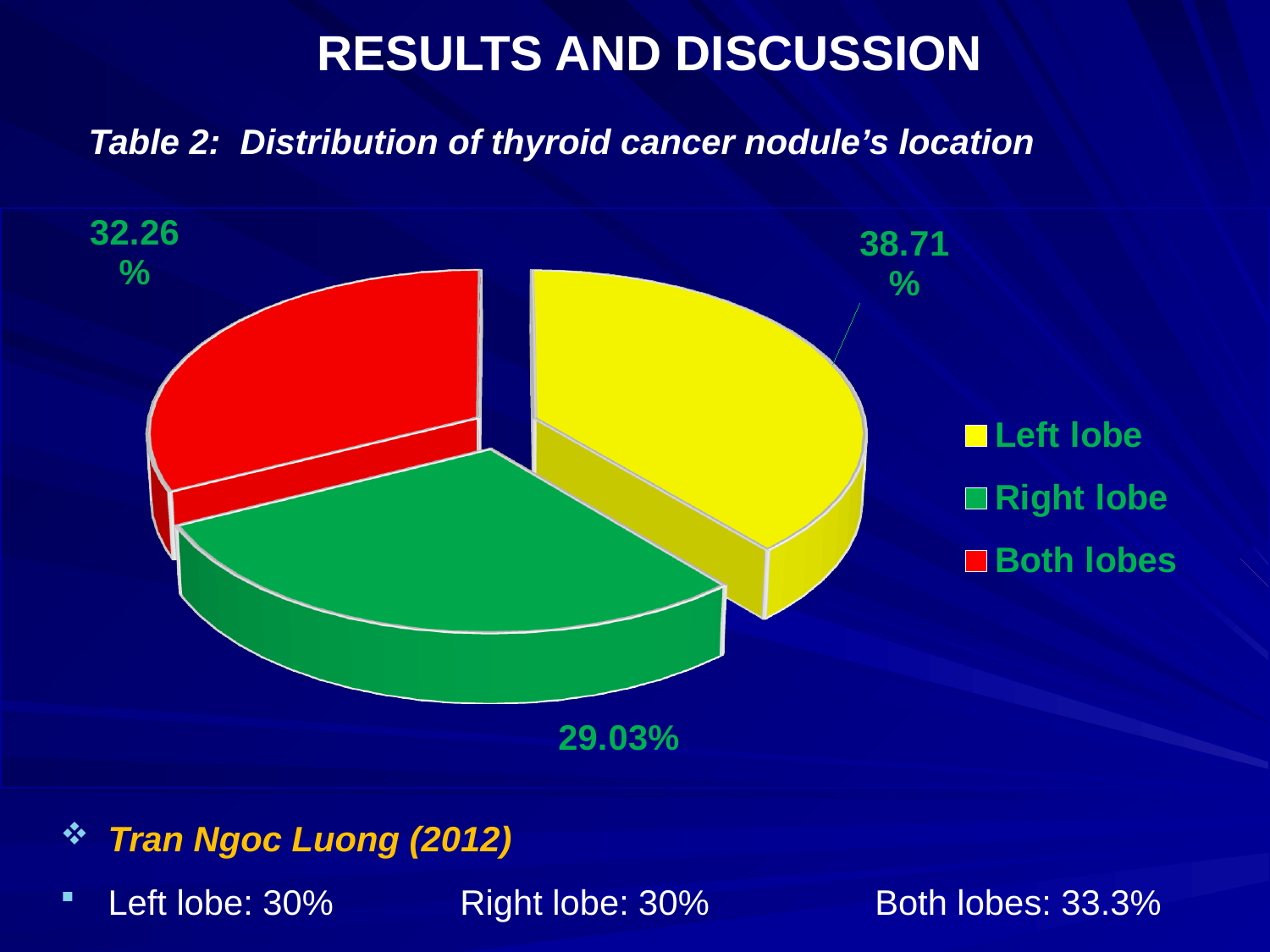
Which colour represents the right lobe in the pie chart? Green What percentage of thyroid cancer nodules are located in the left lobe? 38.71% What is the difference in percentage points between the both lobes share and the right lobe share? 3.23 Which location has the smallest share of thyroid cancer nodules? Right lobe Which is larger, the share for both lobes or the share for the right lobe? Both lobes How many slices does the pie chart have? 3 What type of chart is shown on the slide? Pie chart What percentage of thyroid cancer nodules are located in the right lobe? 29.03% What is the title of the chart? Table 2: Distribution of thyroid cancer nodule's location What percentage of thyroid cancer nodules are located in both lobes? 32.26% Which location has the largest share of thyroid cancer nodules? Left lobe What is the difference in percentage points between the left lobe and the right lobe shares? 9.68